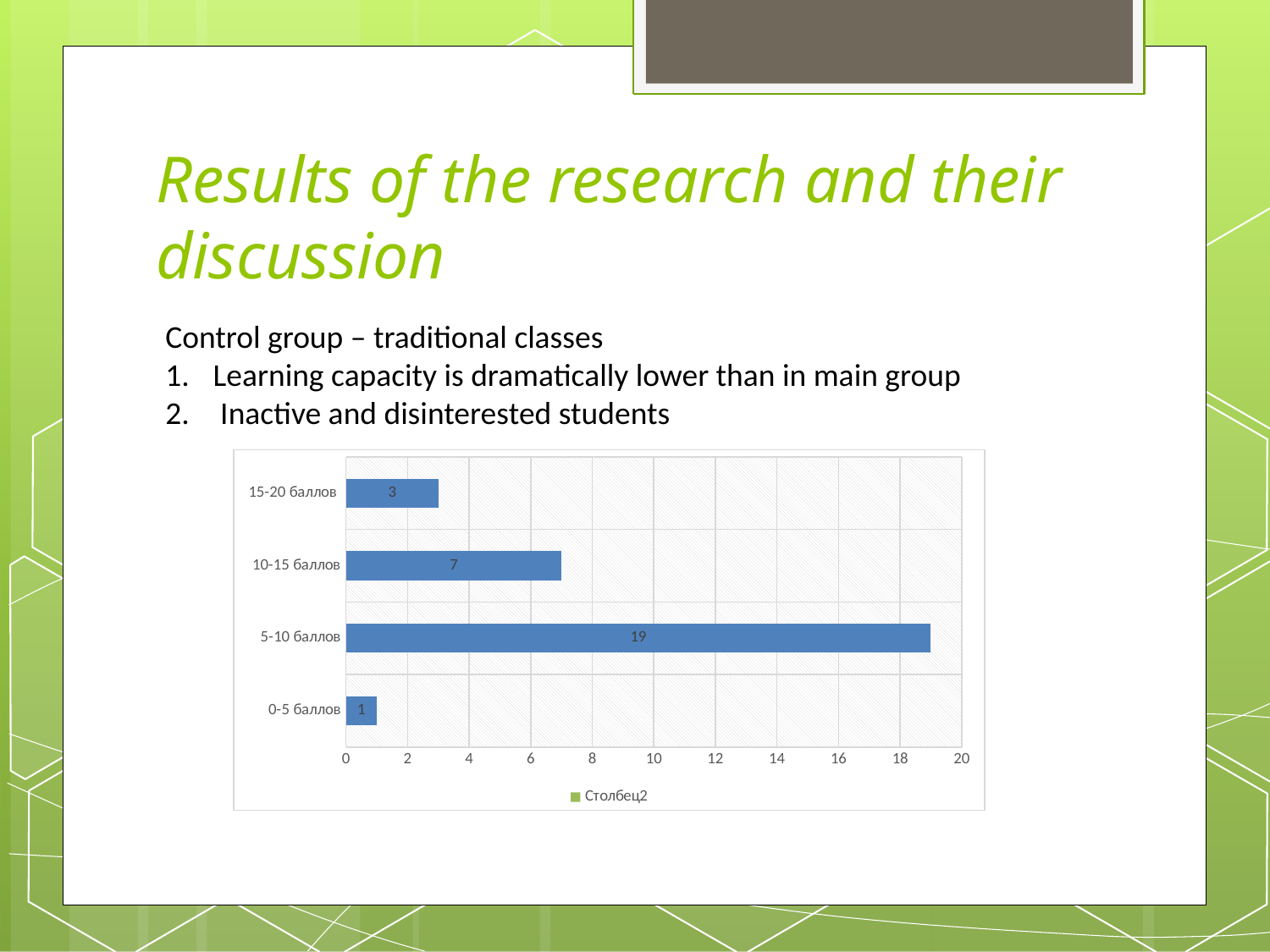
What is the value for 15-20 баллов? 3 What is the difference between the values for 5-10 баллов and 10-15 баллов? 12 What is the value for 0-5 баллов? 1 What kind of chart is shown on the slide? bar chart Which is larger, the value for 10-15 баллов or the value for 15-20 баллов? 10-15 баллов What series name does the legend show? Столбец2 Is the value for 5-10 баллов greater or less than 18? greater Which category has the lowest value? 0-5 баллов What is the value for 10-15 баллов? 7 Which category has the highest value? 5-10 баллов How many categories are shown on the chart? 4 What is the value for 5-10 баллов? 19